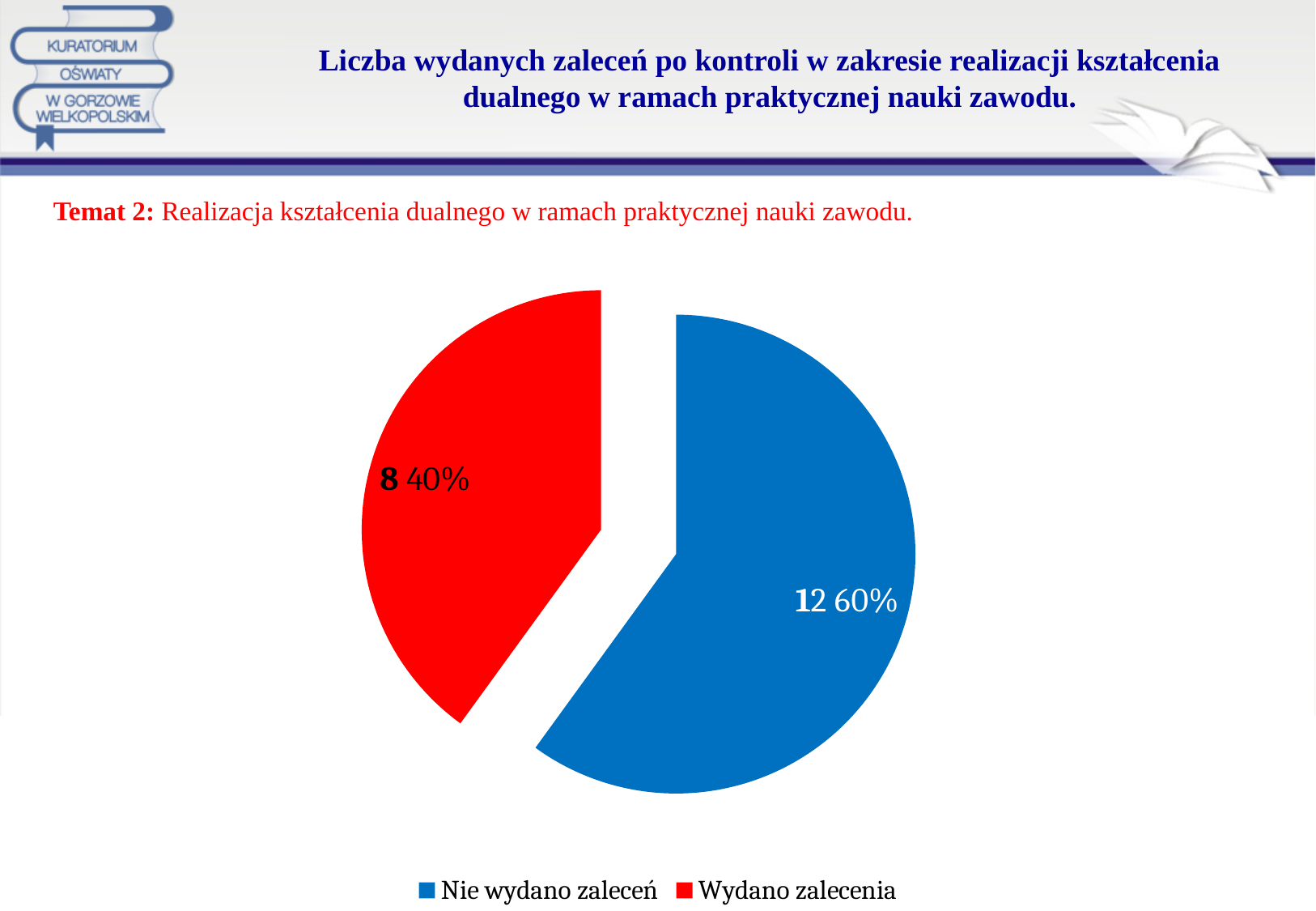
What is the value for "Nie wydano zaleceń"? 12 What is the value for "Wydano zalecenia"? 8 What kind of chart is shown on the slide? pie chart How many entries does the legend list? 2 What colour is the slice for "Wydano zalecenia"? red Which category has the largest slice? Nie wydano zaleceń What share of the pie does "Nie wydano zaleceń" represent? 60% What is the difference between the values for "Nie wydano zaleceń" and "Wydano zalecenia"? 4 How many slices does the pie chart have? 2 Which category has the smallest slice? Wydano zalecenia What share of the pie does "Wydano zalecenia" represent? 40% Which is larger, the value for "Nie wydano zaleceń" or "Wydano zalecenia"? Nie wydano zaleceń